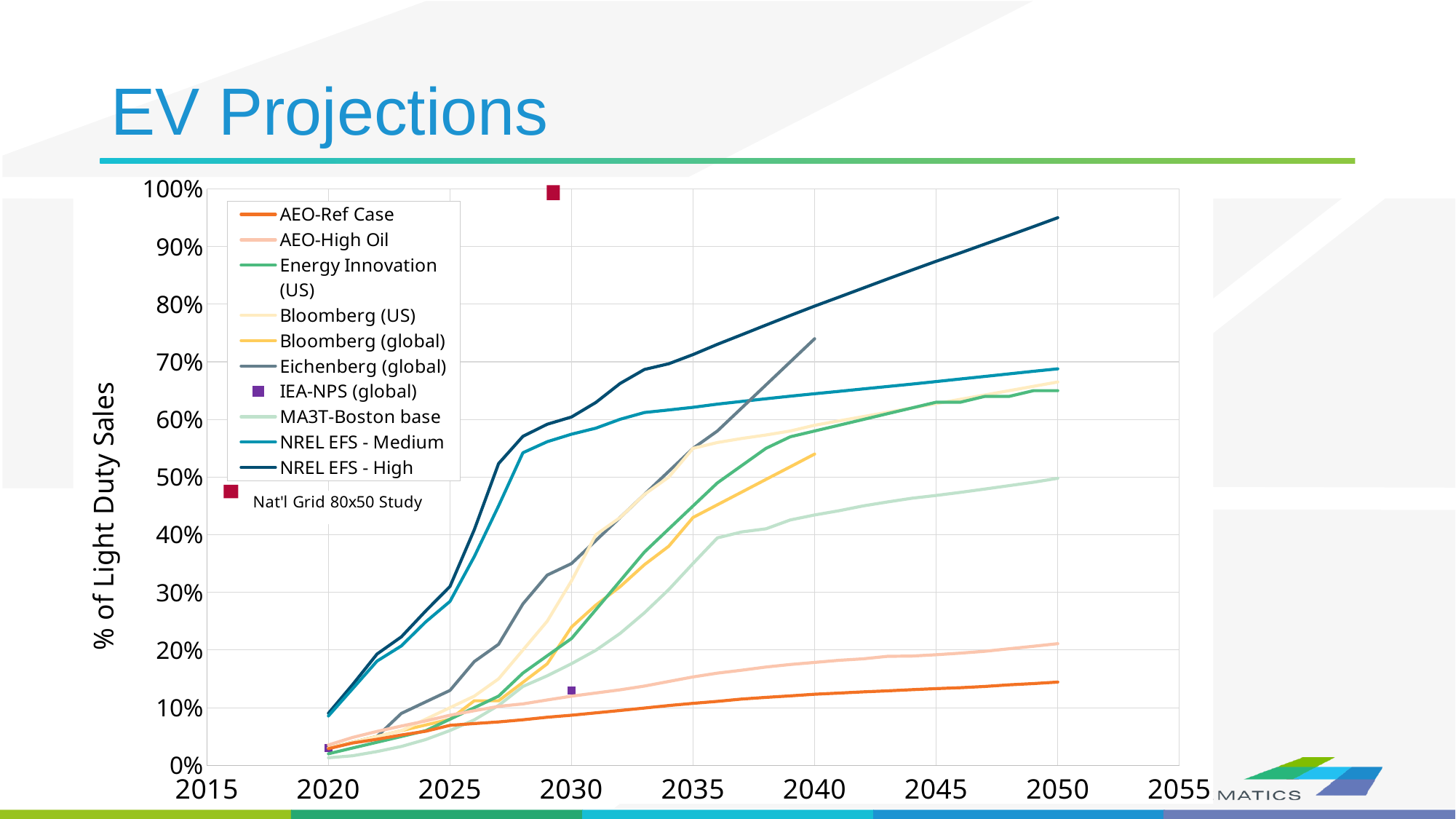
Is the value for NREL EFS - High in 2050 greater or less than 90%? greater How many series does the legend list? 10 Is the value for Eichenberg (global) in 2040 greater or less than 70%? greater Is the value for AEO-Ref Case in 2050 greater or less than 20%? less What is the label on the y axis? % of Light Duty Sales Does the AEO-Ref Case series rise or fall from 2020 to 2050? rise In 2050, which is larger: NREL EFS - Medium or MA3T-Boston base? NREL EFS - Medium Which series has the lowest value in 2050? AEO-Ref Case What kind of chart is shown on the slide? line chart Which series has the highest value in 2050? NREL EFS - High